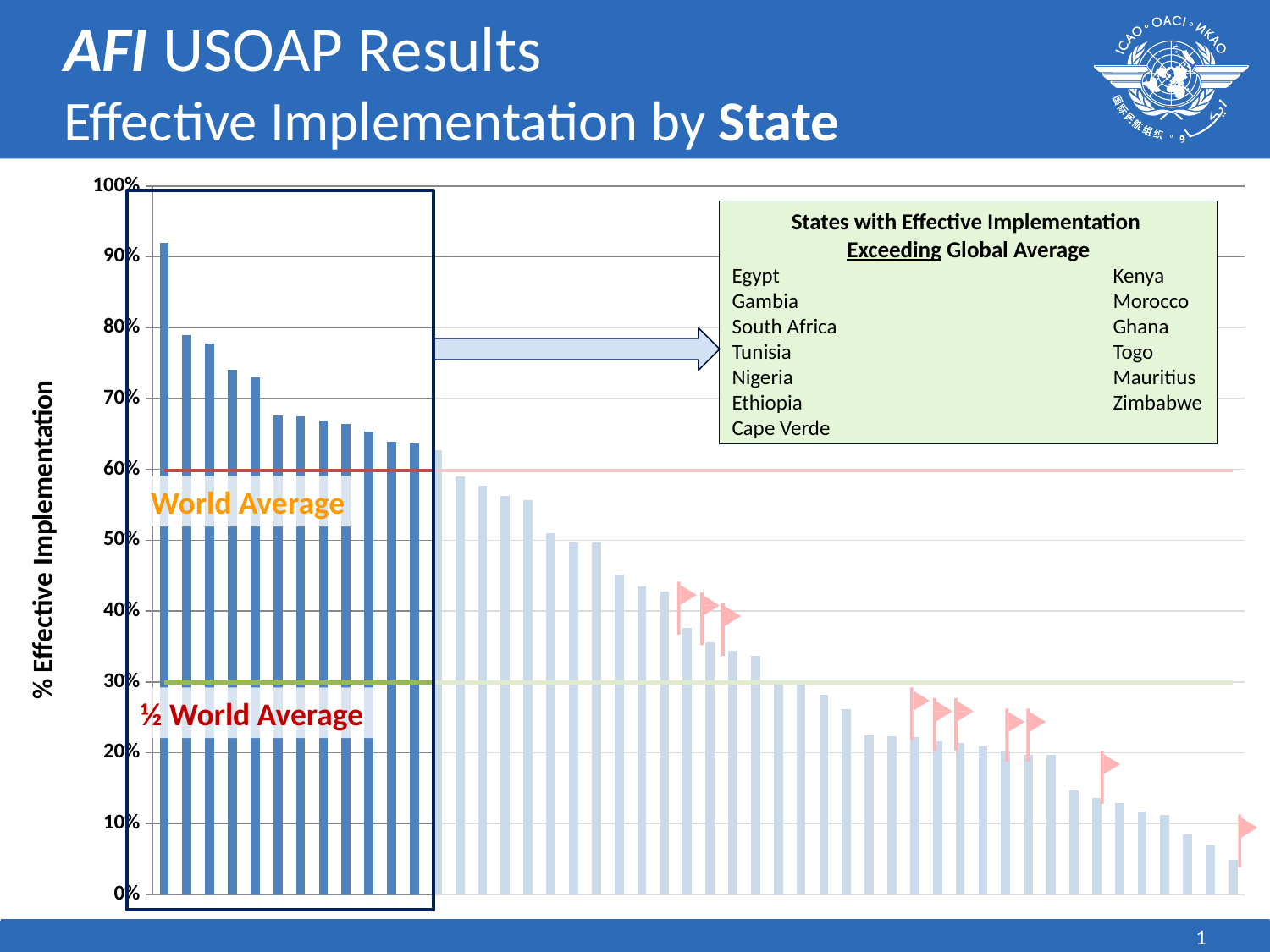
Do the bar values rise or fall from left to right across the chart? fall Is the value of the tallest bar greater or less than 90%? greater What kind of chart is shown on the slide? bar chart How many states are listed in the box titled 'States with Effective Implementation Exceeding Global Average'? 13 Is the value of the second-tallest bar greater or less than 70%? greater What is the label of the vertical axis? % Effective Implementation Is the ½ World Average line drawn at a level greater or less than 40%? less Are the dark blue bars inside the highlighted box above or below the World Average line? above